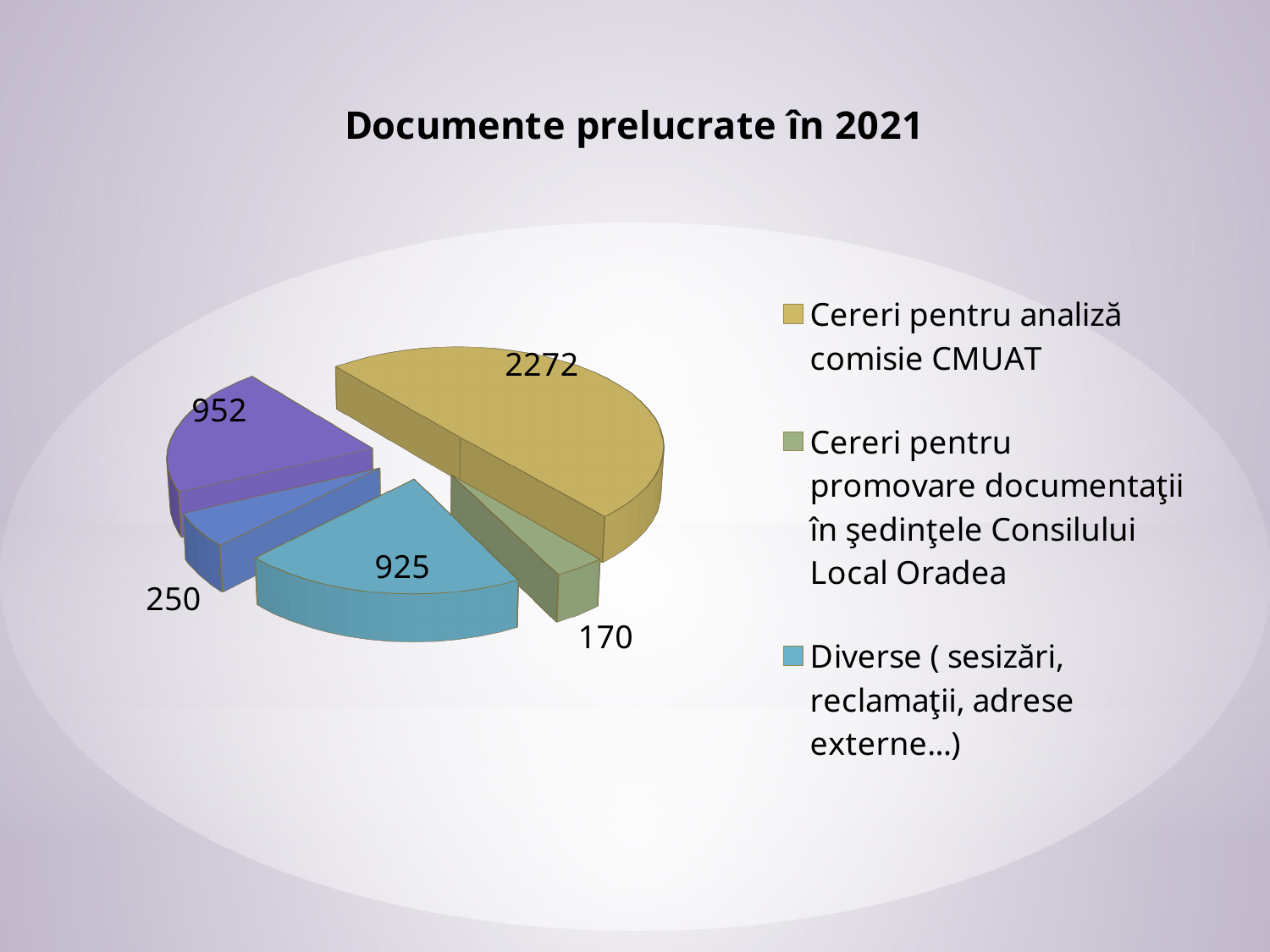
Which is larger: the value for Diverse (sesizări, reclamaţii, adrese externe...) or the value for Cereri pentru promovare documentaţii în şedinţele Consilului Local Oradea? Diverse (sesizări, reclamaţii, adrese externe...) How many entries are listed in the chart's legend? 3 Which category has the largest slice of the pie? Cereri pentru analiză comisie CMUAT What is the difference between the value for Cereri pentru analiză comisie CMUAT and the value for Diverse (sesizări, reclamaţii, adrese externe...)? 1347 What is the title of the chart? Documente prelucrate în 2021 What is the value for Diverse (sesizări, reclamaţii, adrese externe...)? 925 What is the value of the smallest slice of the pie? 170 What is the value for Cereri pentru analiză comisie CMUAT? 2272 What is the total of all the values shown on the pie chart? 4569 How many slices does the pie chart have? 5 What kind of chart is shown on the slide? pie chart What is the value for Cereri pentru promovare documentaţii în şedinţele Consilului Local Oradea? 170